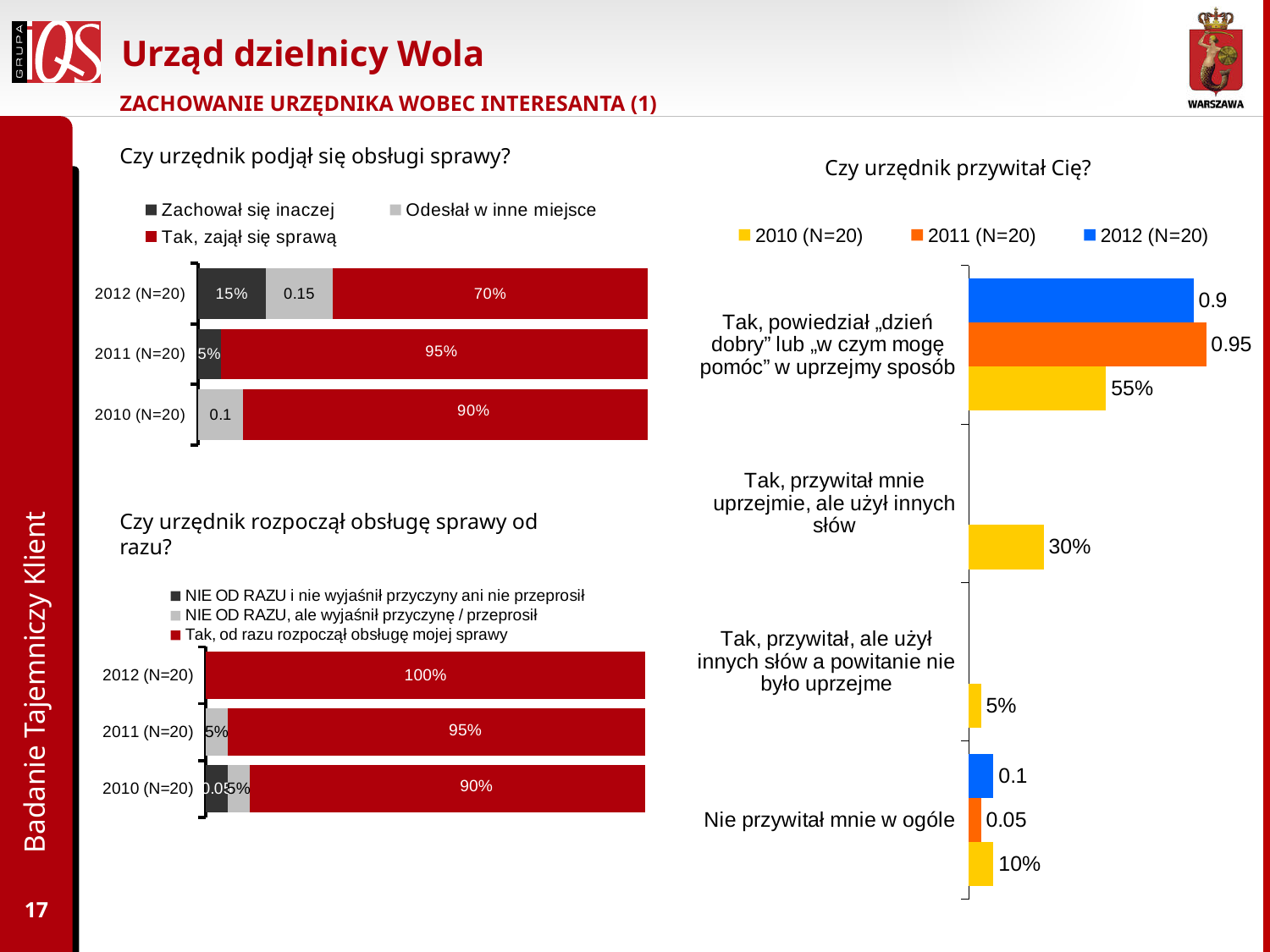
In the chart 'Czy urzędnik podjął się obsługi sprawy?', what is the value for 'Tak, zajął się sprawą' in 2012 (N=20)? 70% In the chart 'Czy urzędnik rozpoczął obsługę sprawy od razu?', what is the value for 'Tak, od razu rozpoczął obsługę mojej sprawy' in 2012 (N=20)? 100% In the chart 'Czy urzędnik podjął się obsługi sprawy?', what is the value for 'Zachował się inaczej' in 2012 (N=20)? 15% In the chart 'Czy urzędnik rozpoczął obsługę sprawy od razu?', what is the value for 'Tak, od razu rozpoczął obsługę mojej sprawy' in 2010 (N=20)? 90% In the chart 'Czy urzędnik podjął się obsługi sprawy?', what is the value for 'Tak, zajął się sprawą' in 2011 (N=20)? 95% In the chart 'Czy urzędnik rozpoczął obsługę sprawy od razu?', how many year categories are shown? 3 In the chart 'Czy urzędnik przywitał Cię?', what is the value for 2010 (N=20) in the category 'Tak, powiedział „dzień dobry” lub „w czym mogę pomóc” w uprzejmy sposób'? 55% In the chart 'Czy urzędnik przywitał Cię?', what is the value for 2010 (N=20) in the category 'Tak, przywitał mnie uprzejmie, ale użył innych słów'? 30% In the chart 'Czy urzędnik przywitał Cię?', which year has the highest value in the category 'Tak, powiedział „dzień dobry” lub „w czym mogę pomóc” w uprzejmy sposób'? 2011 (N=20) In the chart 'Czy urzędnik podjął się obsługi sprawy?', what kind of chart is it? Stacked bar chart In the chart 'Czy urzędnik podjął się obsługi sprawy?', how many series does the legend list? 3 In the chart 'Czy urzędnik przywitał Cię?', what is the value for 2011 (N=20) in the category 'Tak, powiedział „dzień dobry” lub „w czym mogę pomóc” w uprzejmy sposób'? 0.95